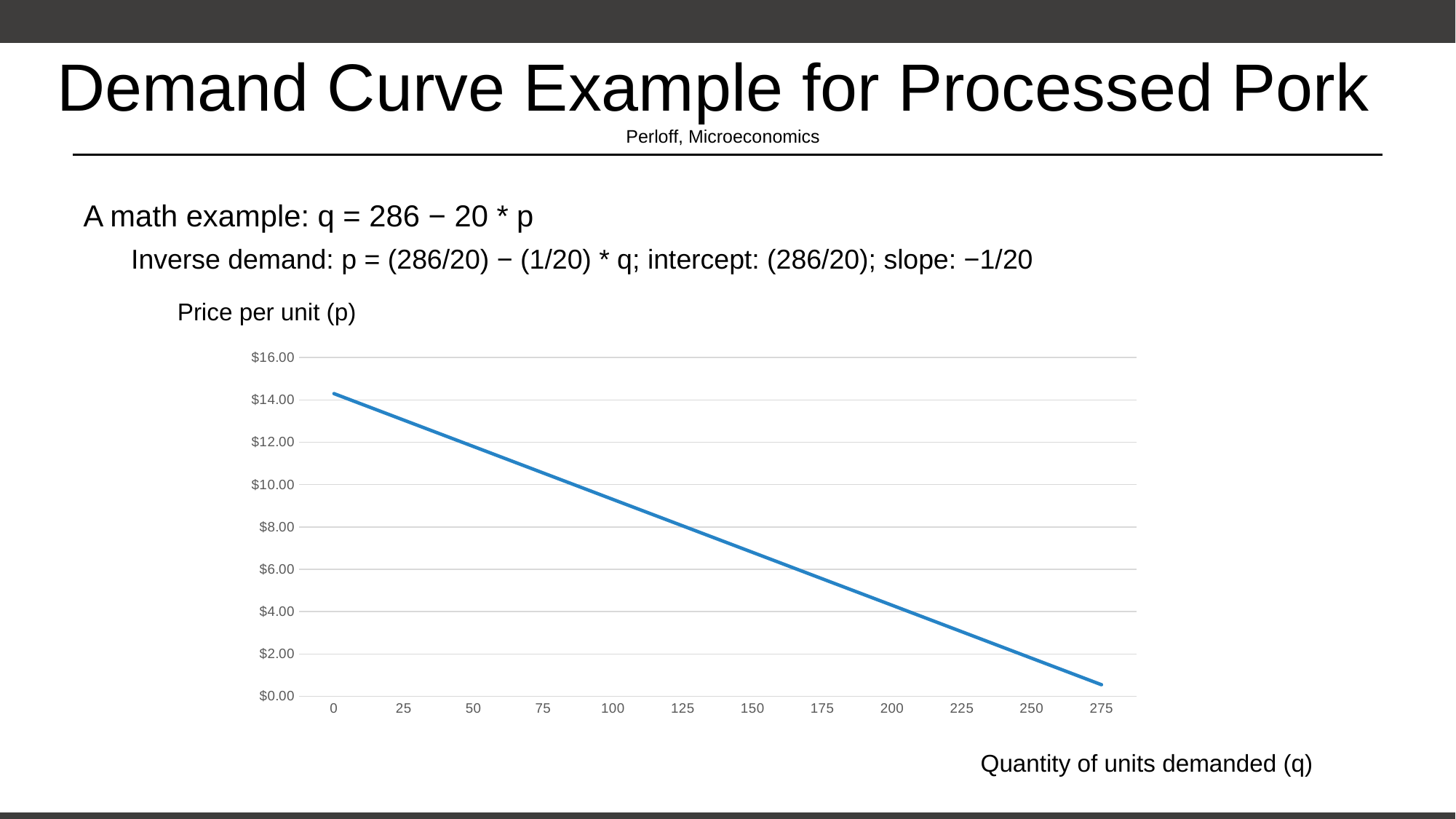
How many tick labels are shown on the x axis? 12 At which quantity on the x axis is the price lowest? 275 Is the price at a quantity of 275 greater or less than $2.00? less Does the price fall or rise as the quantity demanded increases along the x axis? fall What is the label of the horizontal axis of the chart? Quantity of units demanded (q) Which quantity has the higher price on the curve, 25 or 250? 25 What kind of chart is shown on the slide? line chart Is the price at a quantity of 150 greater or less than $6.00? greater At which quantity on the x axis is the price highest? 0 Is the price at a quantity of 100 greater or less than $10.00? less